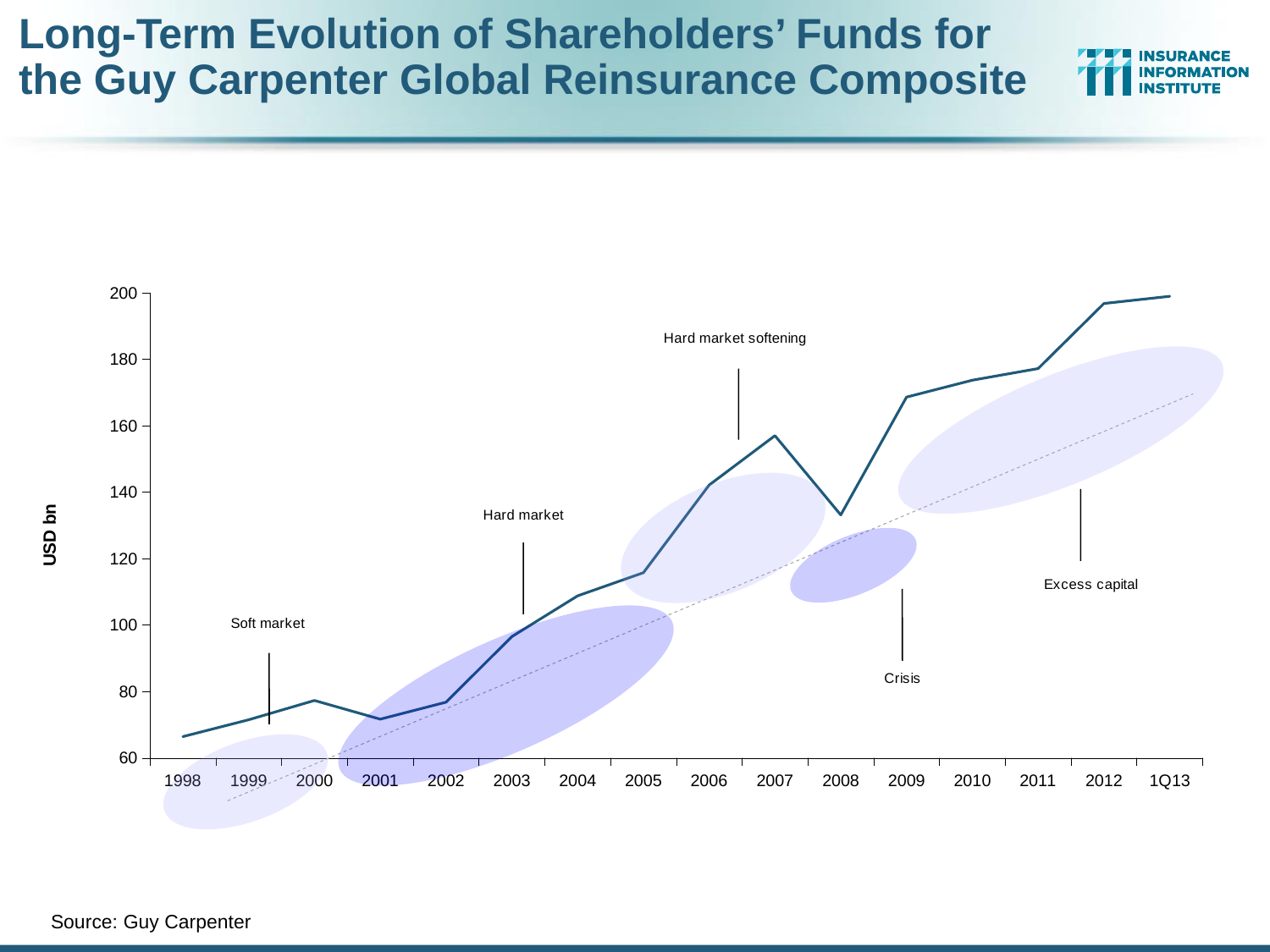
Which annotation is placed near the 2008 dip in the line? Crisis Which is larger, the value for 2000 or the value for 2001? 2000 Is the value for 2008 greater or less than 140? less Which is larger, the value for 2007 or the value for 2008? 2007 Overall, do shareholders' funds rise or fall from 1998 to 1Q13? Rise Is the value for 2007 greater or less than 140? greater How many time points are plotted along the x axis? 16 Is the value for 2009 greater or less than 160? greater What kind of chart is shown on the slide? Line chart What is the label on the y axis? USD bn